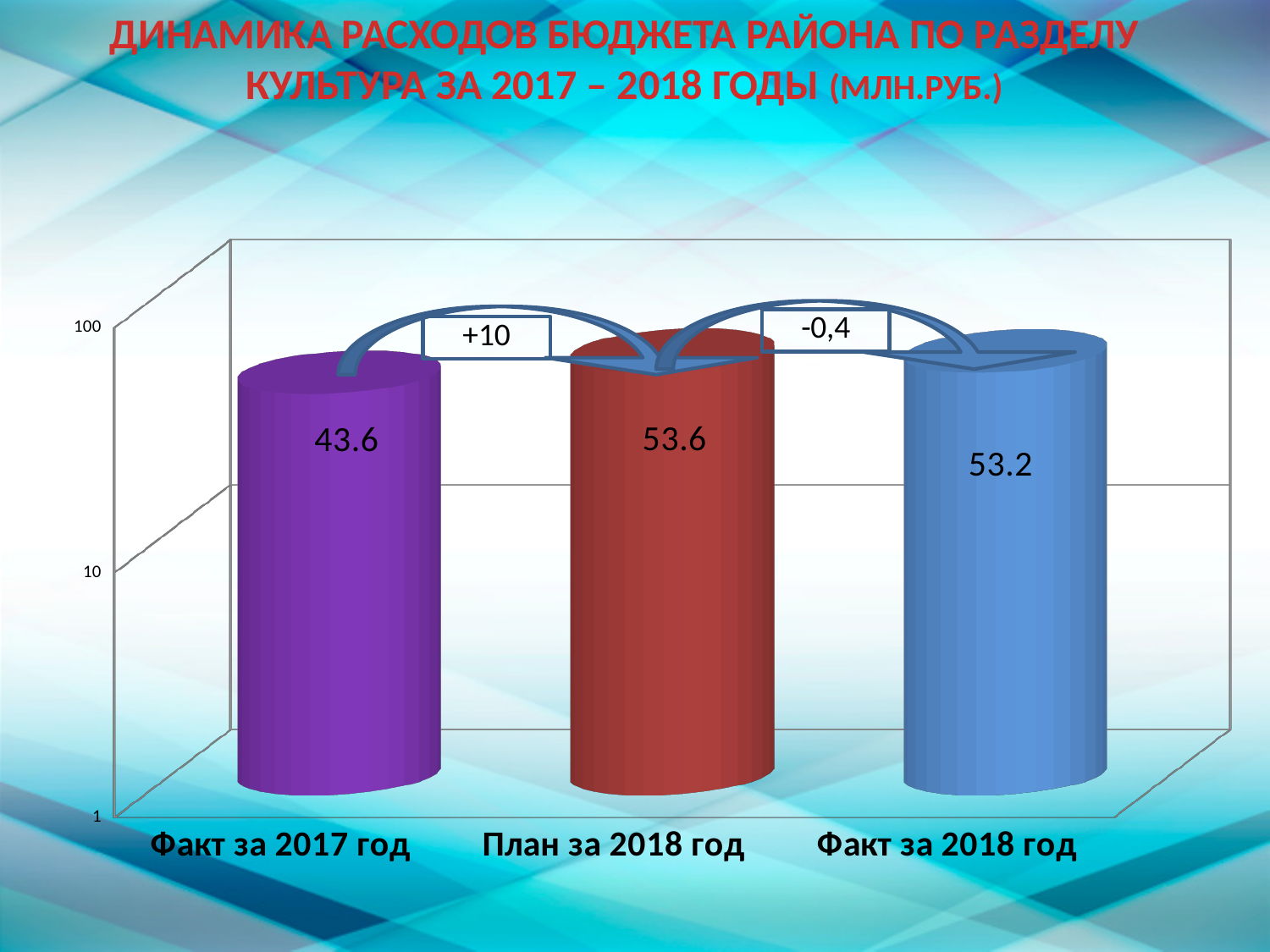
How many categories are shown on the chart? 3 Which is larger, the value for Факт за 2017 год or the value for Факт за 2018 год? Факт за 2018 год Which category has the lowest value? Факт за 2017 год What is the value for Факт за 2018 год? 53.2 Is the value for Факт за 2017 год greater or less than 10? greater What is the difference between План за 2018 год and Факт за 2017 год? 10 What is the value for План за 2018 год? 53.6 Which category has the highest value? План за 2018 год What is the value for Факт за 2017 год? 43.6 What is the difference between План за 2018 год and Факт за 2018 год? 0.4 What kind of chart is shown on the slide? bar chart What unit of measurement is given in the chart title? млн.руб.